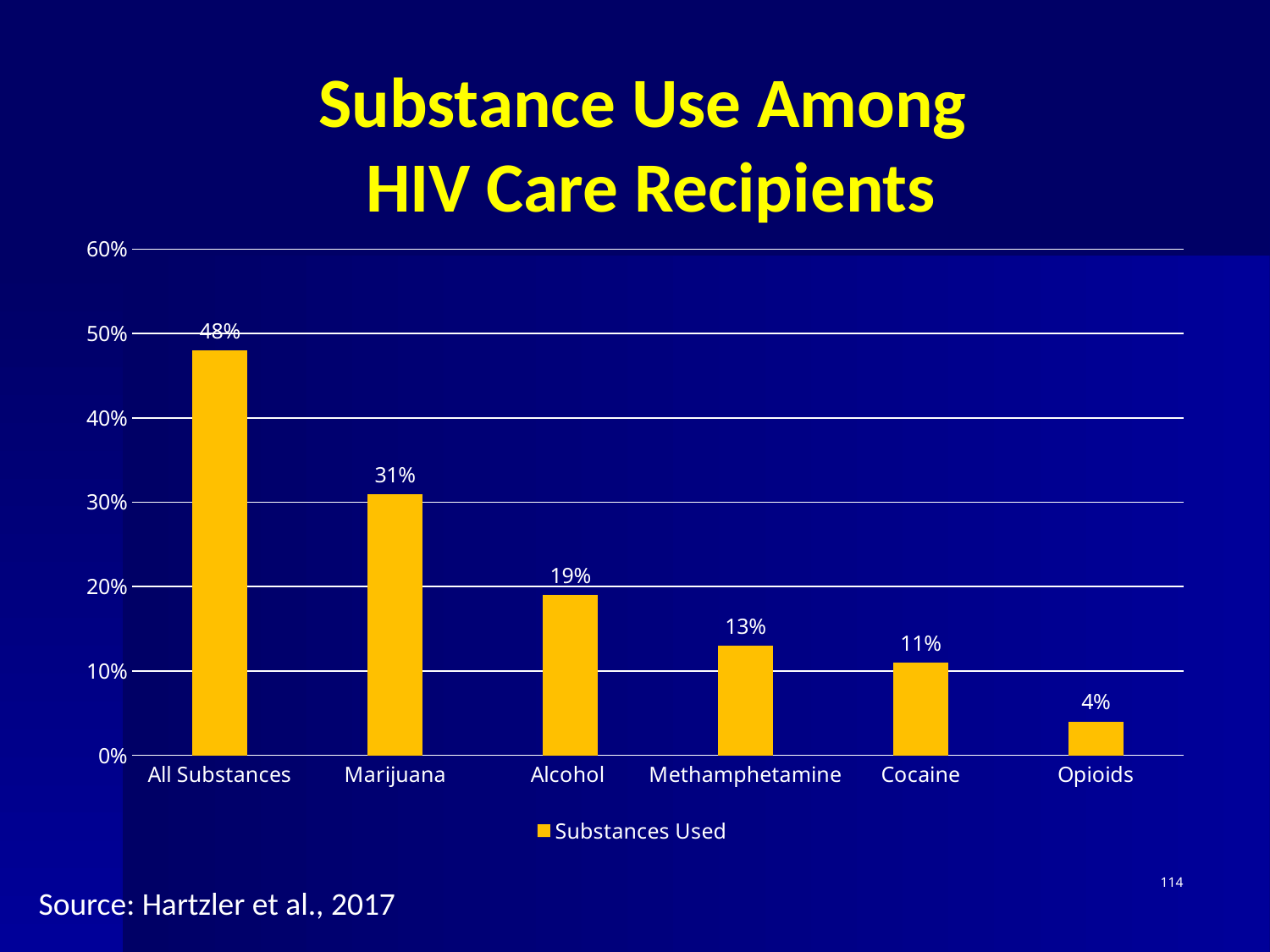
What is the difference between the values for Methamphetamine and Cocaine? 2% What is the difference between the values for Marijuana and Alcohol? 12% What is the legend entry for the series shown? Substances Used How many categories are shown on the x axis? 6 Which is larger, the value for Cocaine or the value for Methamphetamine? Methamphetamine Which category has the highest value? All Substances How many series does the legend list? 1 What is the value for Alcohol? 19% Which category has the lowest value? Opioids What kind of chart is shown on the slide? Bar chart What percentage is shown for Opioids? 4% What percentage is shown for Marijuana? 31%